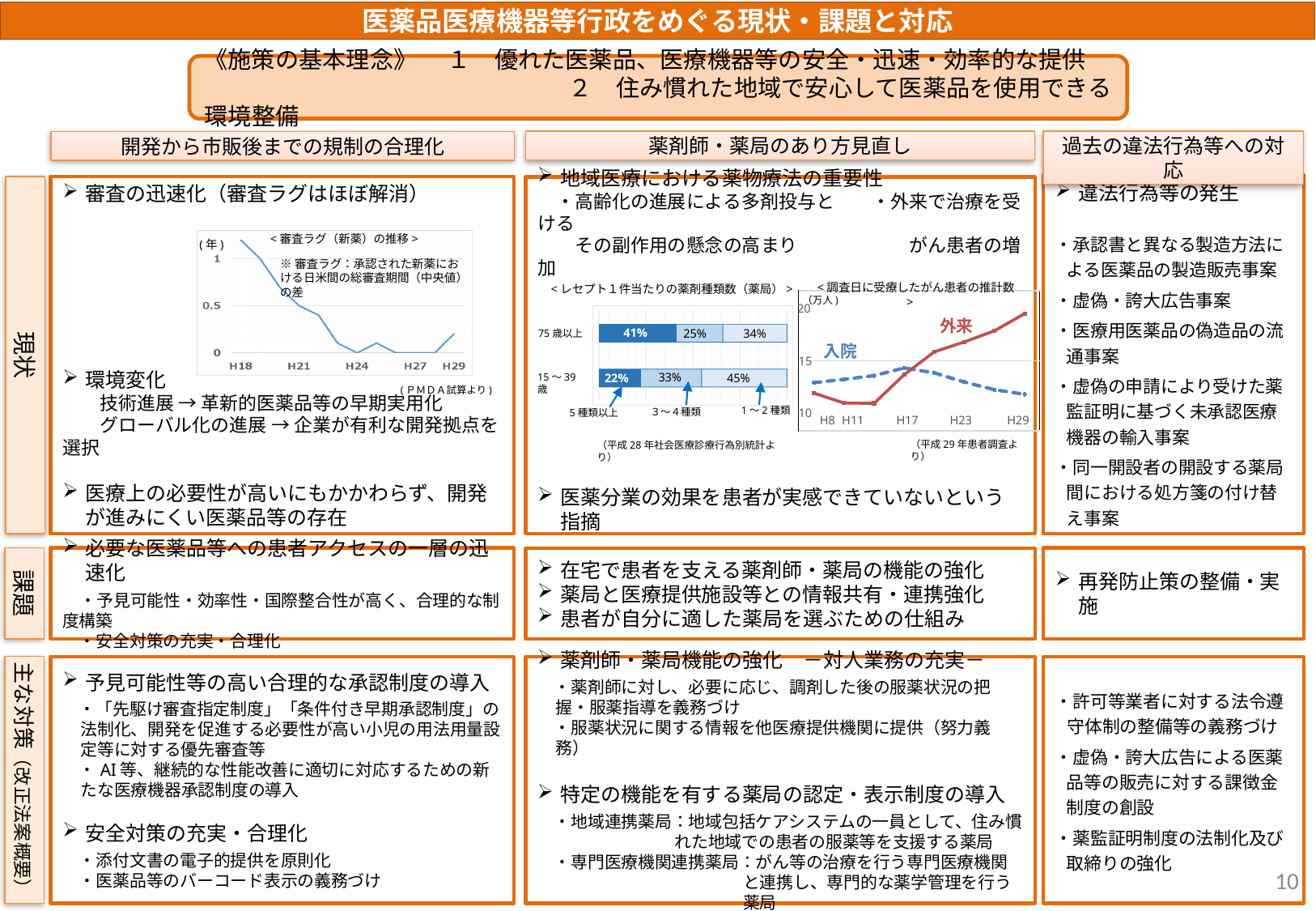
In the chart titled レセプト１件当たりの薬剤種類数（薬局）, what is the share of 1～2種類 for 15～39歳? 45% In the chart titled レセプト１件当たりの薬剤種類数（薬局）, what is the share of 5種類以上 for 75歳以上? 41% In the chart titled 審査ラグ（新薬）の推移, what kind of chart is it? line chart In the chart titled レセプト１件当たりの薬剤種類数（薬局）, how many series (drug-count groups) are shown? 3 In the chart titled 審査ラグ（新薬）の推移, is the value at H18 greater or less than 0.5? greater In the chart titled レセプト１件当たりの薬剤種類数（薬局）, how many percentage points higher is the 5種類以上 share for 75歳以上 than for 15～39歳? 19 In the chart titled 審査ラグ（新薬）の推移, is the value at H27 greater or less than 0.5? less In the chart titled 調査日に受療したがん患者の推計数, how many series are plotted? 2 In the chart titled レセプト１件当たりの薬剤種類数（薬局）, how many age categories are shown? 2 In the chart titled 調査日に受療したがん患者の推計数, is the 外来 value at H29 greater or less than 15? greater In the chart titled 調査日に受療したがん患者の推計数, which series is higher at H29, 入院 or 外来? 外来 In the chart titled 審査ラグ（新薬）の推移, do the values generally rise or fall from H18 to H27? fall